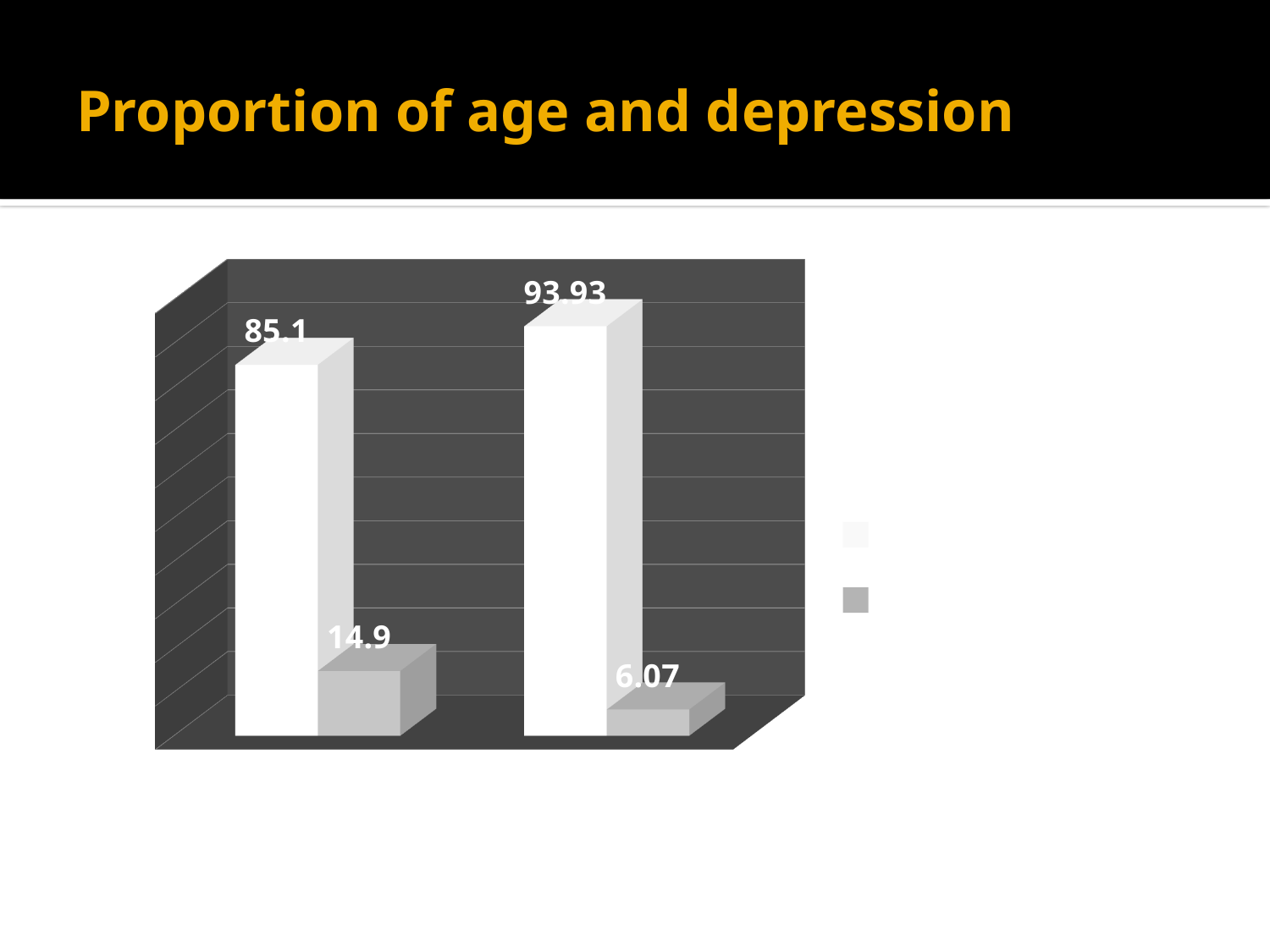
What is the difference between the white bar and the gray bar in the left group? 70.2 What is the title of the chart on the slide? Proportion of age and depression Which bar has the highest value in the chart? the white bar in the right group (93.93) What kind of chart is shown on the slide? bar chart How many series does the legend show? 2 Which is larger: the gray bar in the left group or the gray bar in the right group? the gray bar in the left group How many groups of bars are plotted in the chart? 2 What is the value labelled on the white bar in the left group? 85.1 What is the value labelled on the gray bar in the left group? 14.9 Which bar has the lowest value in the chart? the gray bar in the right group (6.07) What is the value labelled on the white bar in the right group? 93.93 What is the value labelled on the gray bar in the right group? 6.07